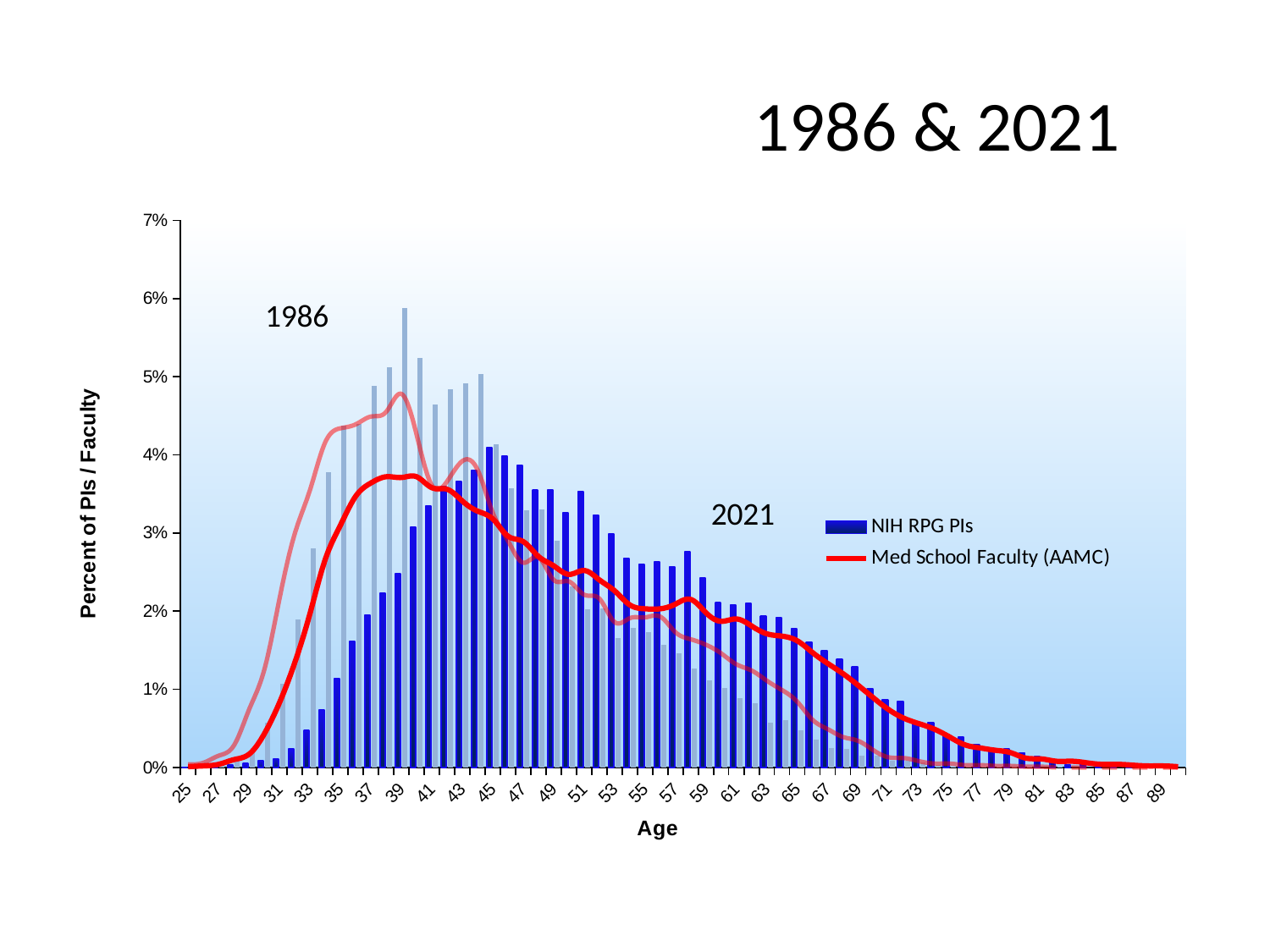
Is the 1986 NIH RPG PIs bar at age 39 greater or less than 5%? greater What kind of chart is shown on the slide? bar and line chart How many series does the legend list? 2 At age 35, which NIH RPG PIs bar is taller, 1986 or 2021? 1986 What is the label on the vertical axis? Percent of PIs / Faculty Is the 2021 NIH RPG PIs bar at age 31 greater or less than 1%? less What is the title of the chart? 1986 & 2021 Is the 1986 Med School Faculty (AAMC) line at age 39 greater or less than 4%? greater At which age is the 1986 NIH RPG PIs bar the tallest? 39 At age 55, which NIH RPG PIs bar is taller, 1986 or 2021? 2021 From age 65 to age 89, do the 2021 NIH RPG PIs bars rise or fall? fall